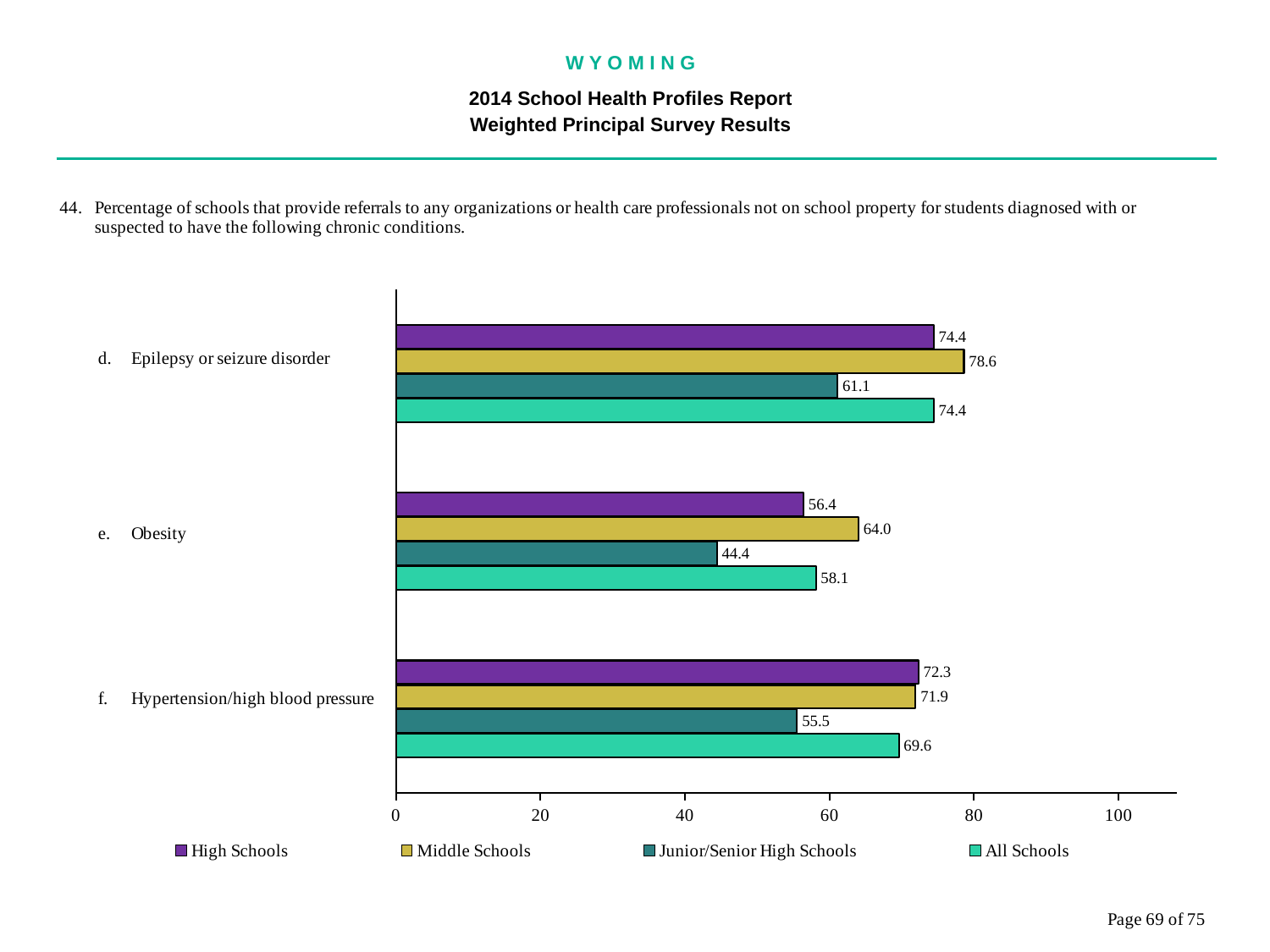
Which is larger for Epilepsy or seizure disorder: the Middle Schools value or the High Schools value? Middle Schools What is the value for Junior/Senior High Schools for Obesity? 44.4 What is the value for Middle Schools for Epilepsy or seizure disorder? 78.6 What is the difference between the Middle Schools and Junior/Senior High Schools values for Obesity? 19.6 What is the value for High Schools for Hypertension/high blood pressure? 72.3 Which school type has the lowest value for Epilepsy or seizure disorder? Junior/Senior High Schools How many chronic conditions (categories) are shown on the chart? 3 What is the value for All Schools for Hypertension/high blood pressure? 69.6 Which series is shown in the legend immediately after High Schools? Middle Schools How many series does the legend list? 4 Which school type has the highest value for Obesity? Middle Schools What kind of chart is shown on the slide? Bar chart